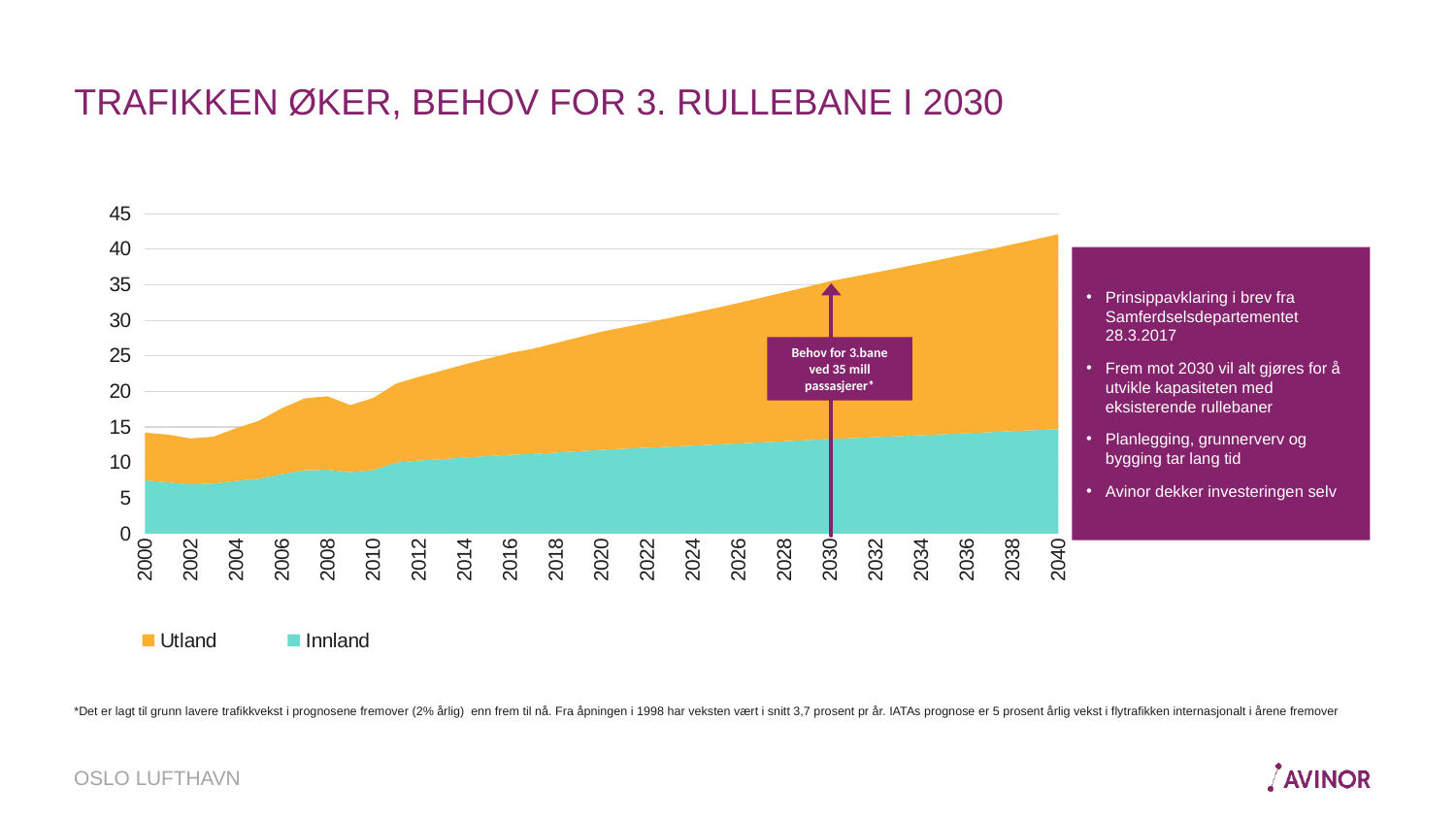
In 2040, which series is larger, Utland or Innland? Utland Is the Innland value for 2030 greater or less than 10? greater Which series is shown in orange in the chart? Utland Which year on the x axis does the arrow labelled 'Behov for 3.bane ved 35 mill passasjerer' point to? 2030 Is the Innland value for 2000 greater or less than 10? less Is the total (Utland plus Innland) for 2040 greater or less than 40? greater Does the total passenger traffic rise or fall from 2000 to 2040 in the chart? Rises What kind of chart is shown on the slide? Stacked area chart What are the two series named in the chart legend? Utland and Innland How many series does the chart legend list? 2